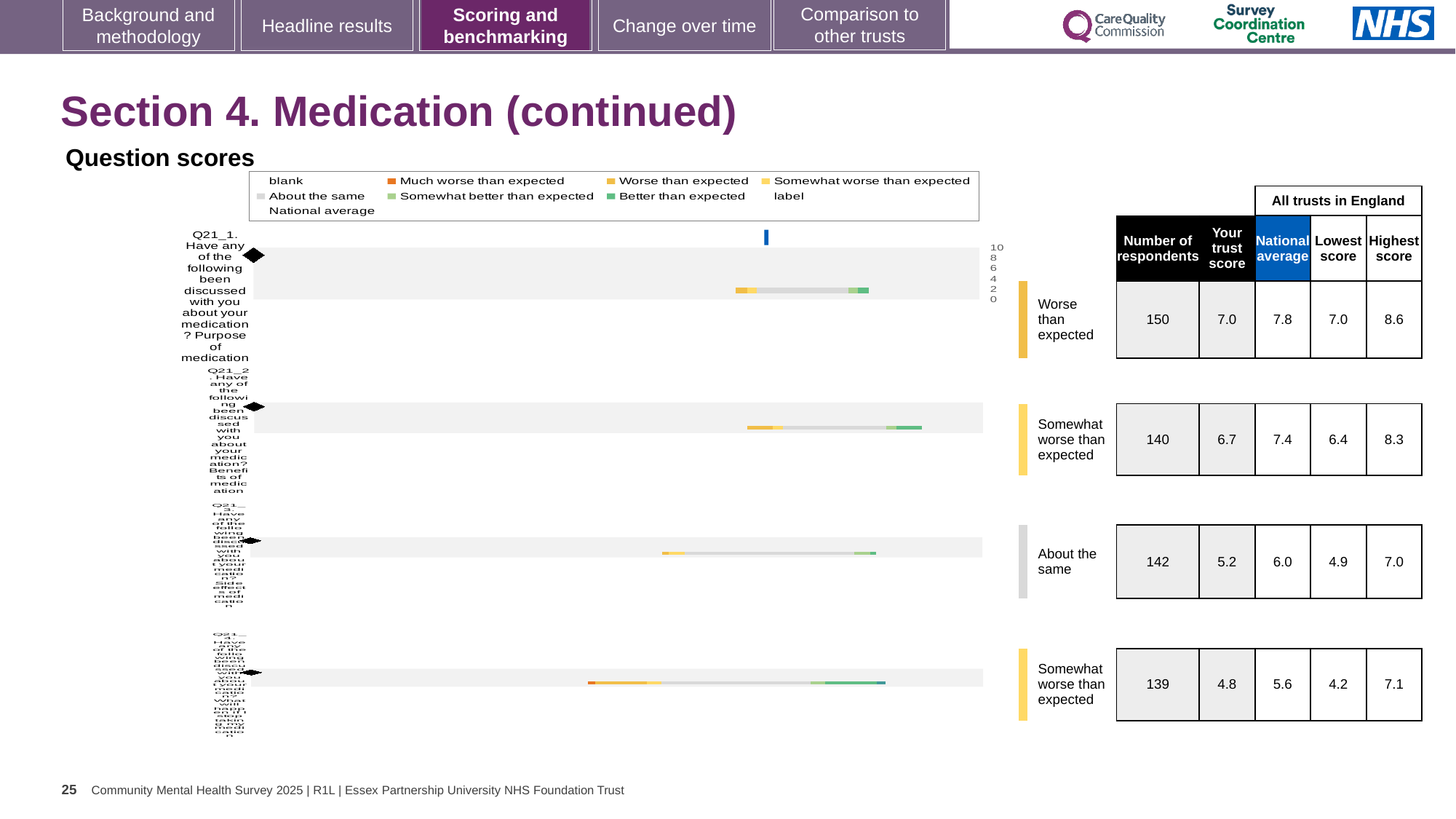
What benchmark category is shown for the third row (Q21_3)? About the same For the third row (Q21_3), which is larger: the trust score or the national average? National average (6.0) What is the national average for the first row (Q21_1, purpose of medication)? 7.8 For the first row (Q21_1), how much higher is the national average than the trust score? 0.8 What is the highest score across all trusts in England for the fourth row (Q21_4)? 7.1 What is the 'Your trust score' value for the first row (Q21_1, purpose of medication)? 7.0 How many questions (rows) are plotted in the question scores chart? 4 Which row has the highest 'Your trust score'? Q21_1 (first row), 7.0 What kind of chart is used to show the question scores on this slide? bar chart How many respondents are shown for the second row (Q21_2, benefits of medication)? 140 Do the 'Your trust score' values rise or fall going down the rows from Q21_1 to Q21_4? fall Which row has the lowest 'Your trust score'? Q21_4 (fourth row), 4.8